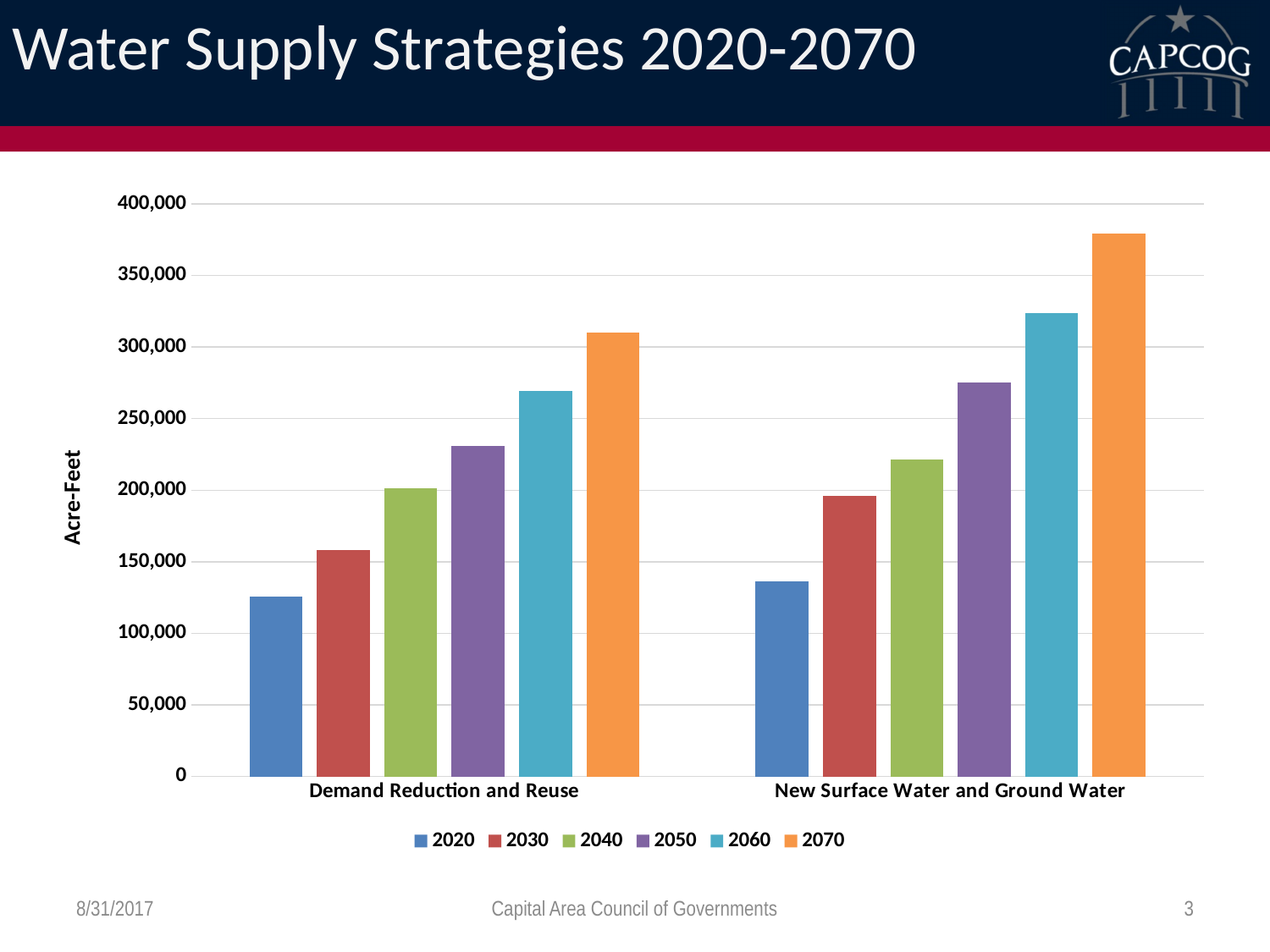
What kind of chart is shown on the slide? bar chart How many categories are shown on the x axis? 2 Is the value for 2060 in Demand Reduction and Reuse greater or less than 250,000? greater Is the value for 2040 in New Surface Water and Ground Water greater or less than 200,000? greater How many series does the legend list? 6 Is the value for 2070 in New Surface Water and Ground Water greater or less than 350,000? greater Which is larger, the 2070 value for Demand Reduction and Reuse or the 2070 value for New Surface Water and Ground Water? New Surface Water and Ground Water Which category and year has the tallest bar in the chart? New Surface Water and Ground Water, 2070 Which category and year has the shortest bar in the chart? Demand Reduction and Reuse, 2020 Within each category, do the values rise or fall from 2020 to 2070? rise What is the label on the vertical axis? Acre-Feet